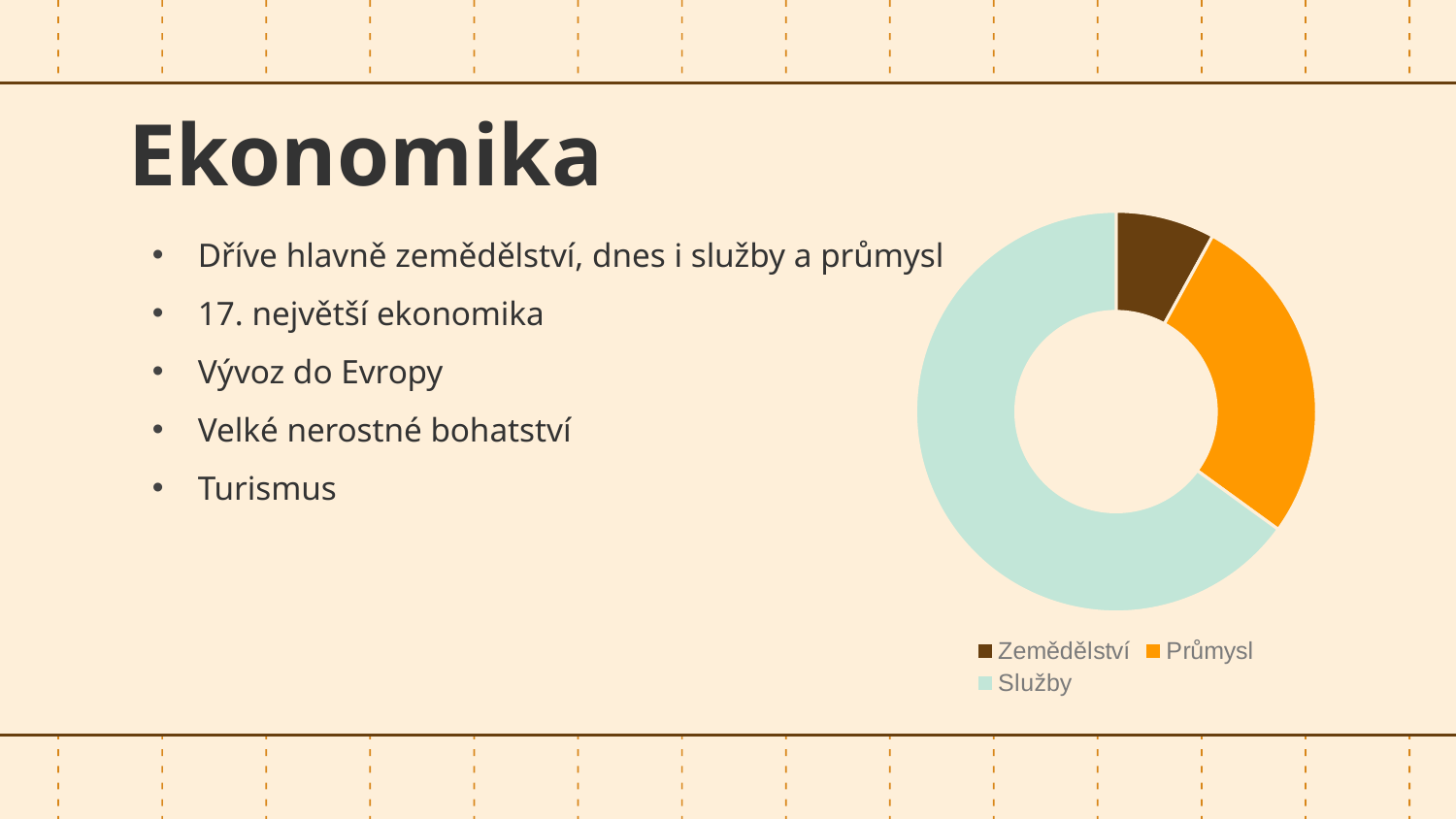
Which has a larger share, Průmysl or Zemědělství? Průmysl Which category has the smallest share of the chart? Zemědělství What kind of chart is shown on the slide? doughnut chart Which has a larger share, Služby or Průmysl? Služby How many entries does the chart's legend list? 3 Which category is shown in orange? Průmysl Which category is shown in dark brown? Zemědělství Which category has the largest share of the chart? Služby How many categories does the chart show? 3